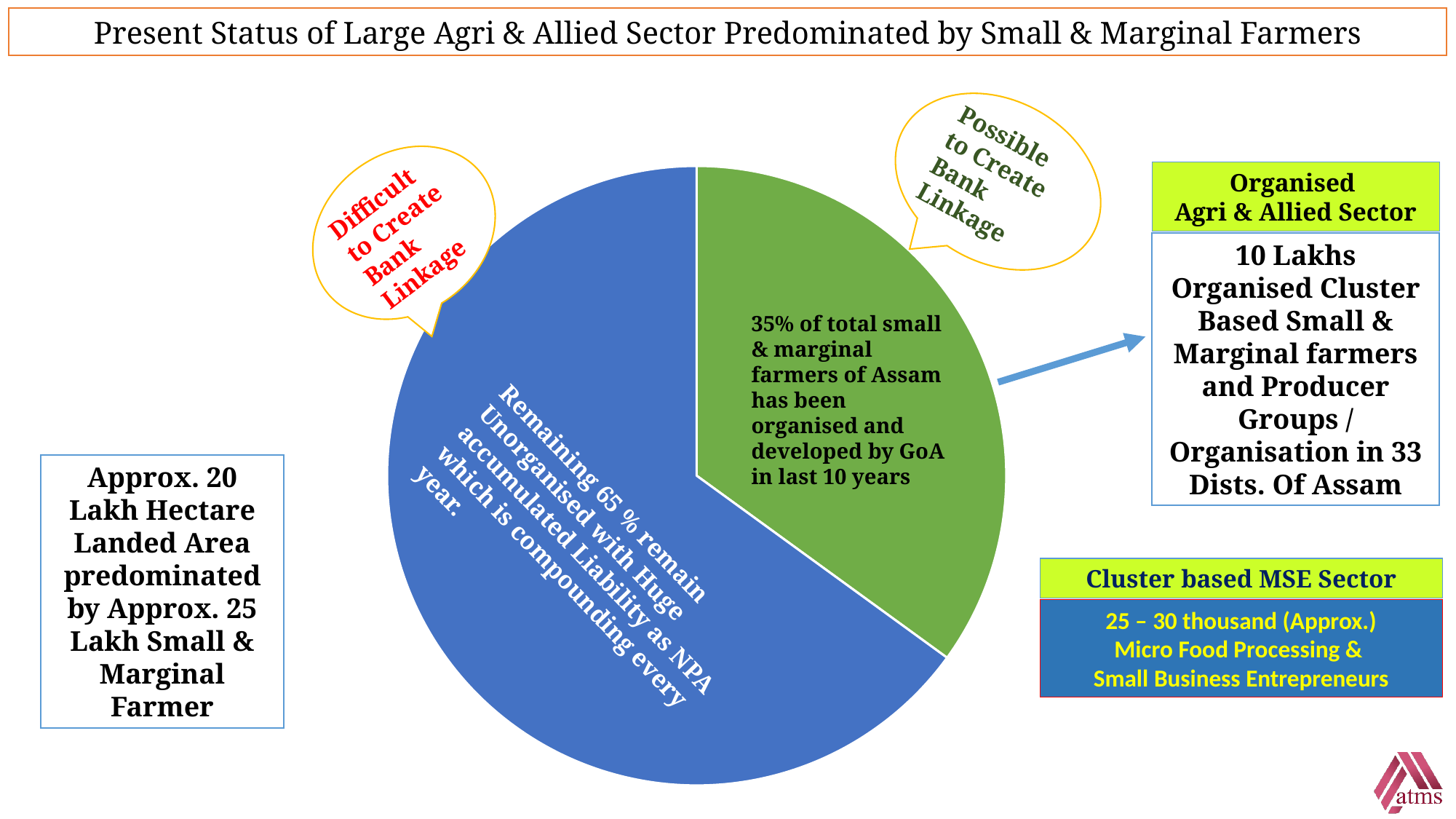
What is the difference in percentage points between the unorganised slice and the organised slice of the pie chart? 30 percentage points What colour is the slice representing the 65% of farmers who remain unorganised? blue Which slice of the pie chart is the smallest? organised farmers (35%) Which slice of the pie chart is larger: the organised farmers or the unorganised farmers? unorganised farmers What share of the pie does the green slice represent? 35% Is the share of organised farmers in the pie chart greater or less than the share of unorganised farmers? less What does the speech bubble pointing to the green slice of the pie chart say? Possible to Create Bank Linkage What kind of chart is shown on the slide? pie chart What percentage of total small and marginal farmers of Assam has been organised and developed by GoA in the last 10 years, according to the pie chart? 35% How many slices does the pie chart have? 2 What percentage of small and marginal farmers remain unorganised, according to the pie chart? 65%